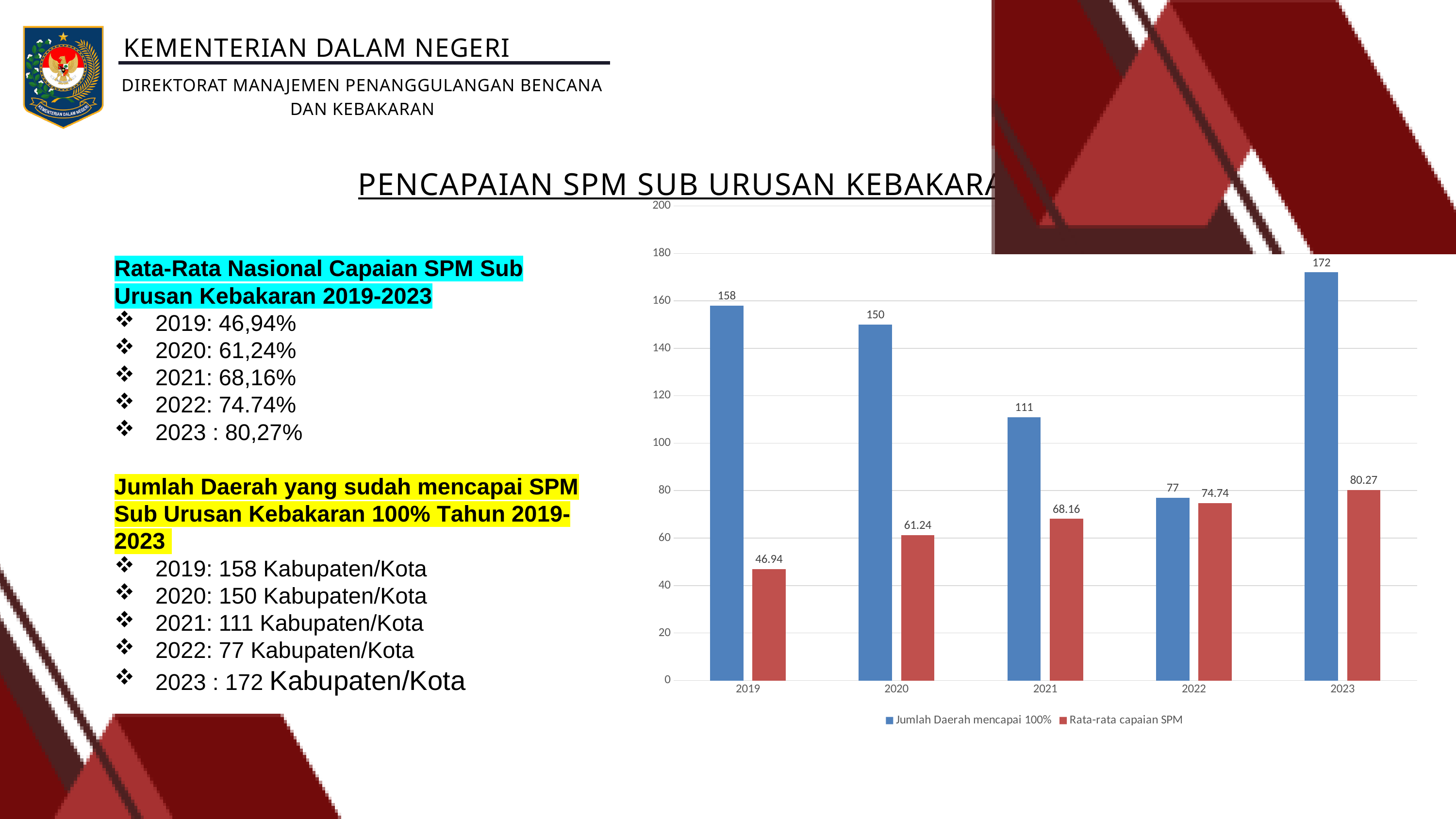
Which year has the highest value for Jumlah Daerah mencapai 100%? 2023 How many years are shown on the x axis of the chart? 5 Does the Rata-rata capaian SPM series rise or fall from 2019 to 2023? Rise What is the value of Jumlah Daerah mencapai 100% for 2019? 158 What is the value of Rata-rata capaian SPM for 2021? 68.16 What is the difference between the Jumlah Daerah mencapai 100% values for 2019 and 2020? 8 What is the value of Jumlah Daerah mencapai 100% for 2022? 77 How many series does the chart legend list? 2 Which year has the lowest value for Rata-rata capaian SPM? 2019 What colour are the bars for the Rata-rata capaian SPM series? Red What kind of chart is shown on the slide? Bar chart Which is larger for 2022: Jumlah Daerah mencapai 100% or Rata-rata capaian SPM? Jumlah Daerah mencapai 100%